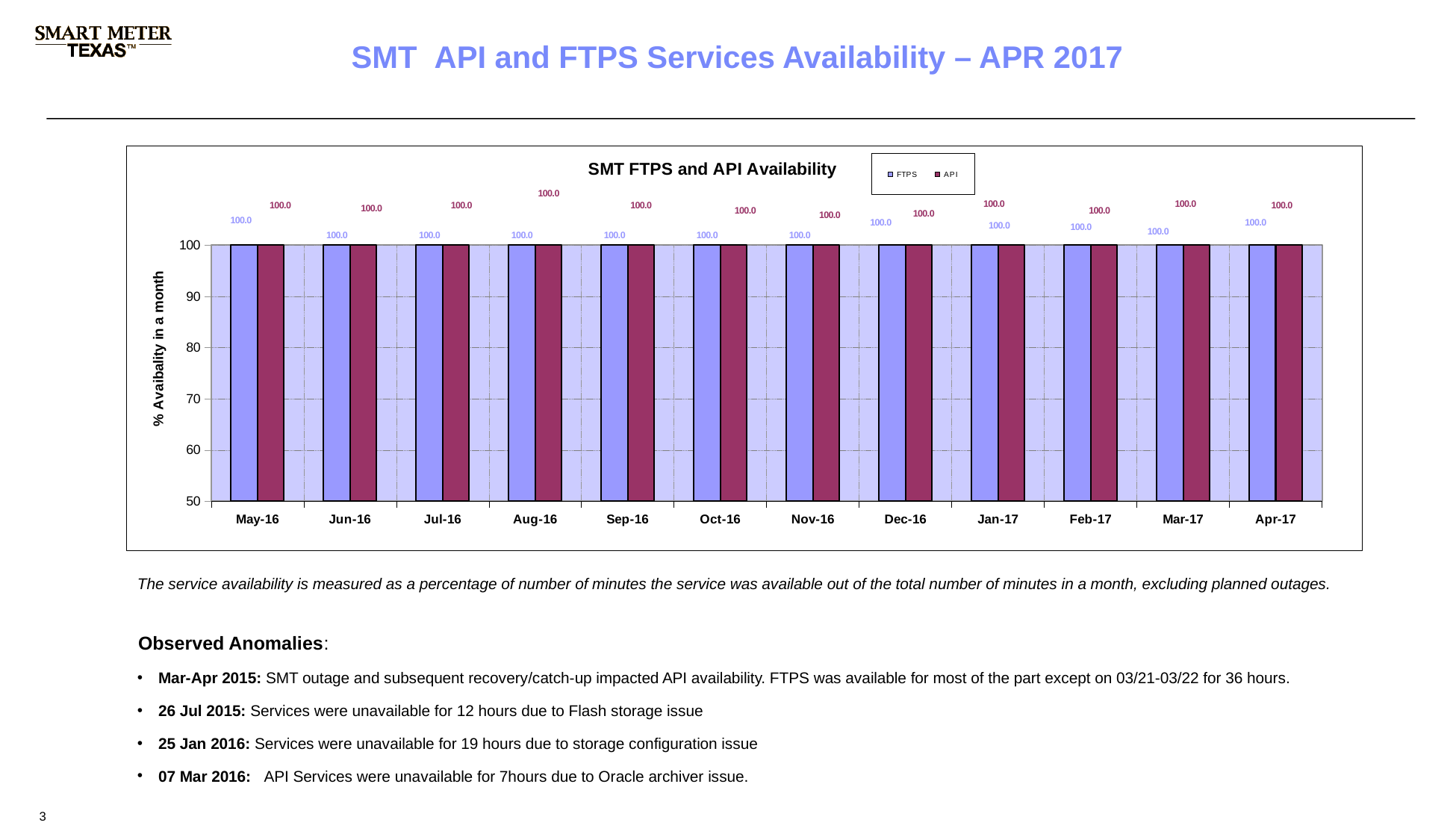
Is the API availability value for Nov-16 greater or less than 90? greater How many months are shown on the x axis of the chart? 12 What is the label on the y axis of the chart? % Avaibality in a month What is the API availability value for Apr-17? 100.0 How many series does the chart legend list? 2 What is the title of the chart? SMT FTPS and API Availability Do the FTPS availability values rise, fall, or stay flat from May-16 to Apr-17? stay flat What is the FTPS availability value for Dec-16? 100.0 What is the FTPS availability value for May-16? 100.0 What is the API availability value for Sep-16? 100.0 What kind of chart is shown on the slide? bar chart What is the difference between the FTPS and API availability values for Jan-17? 0.0